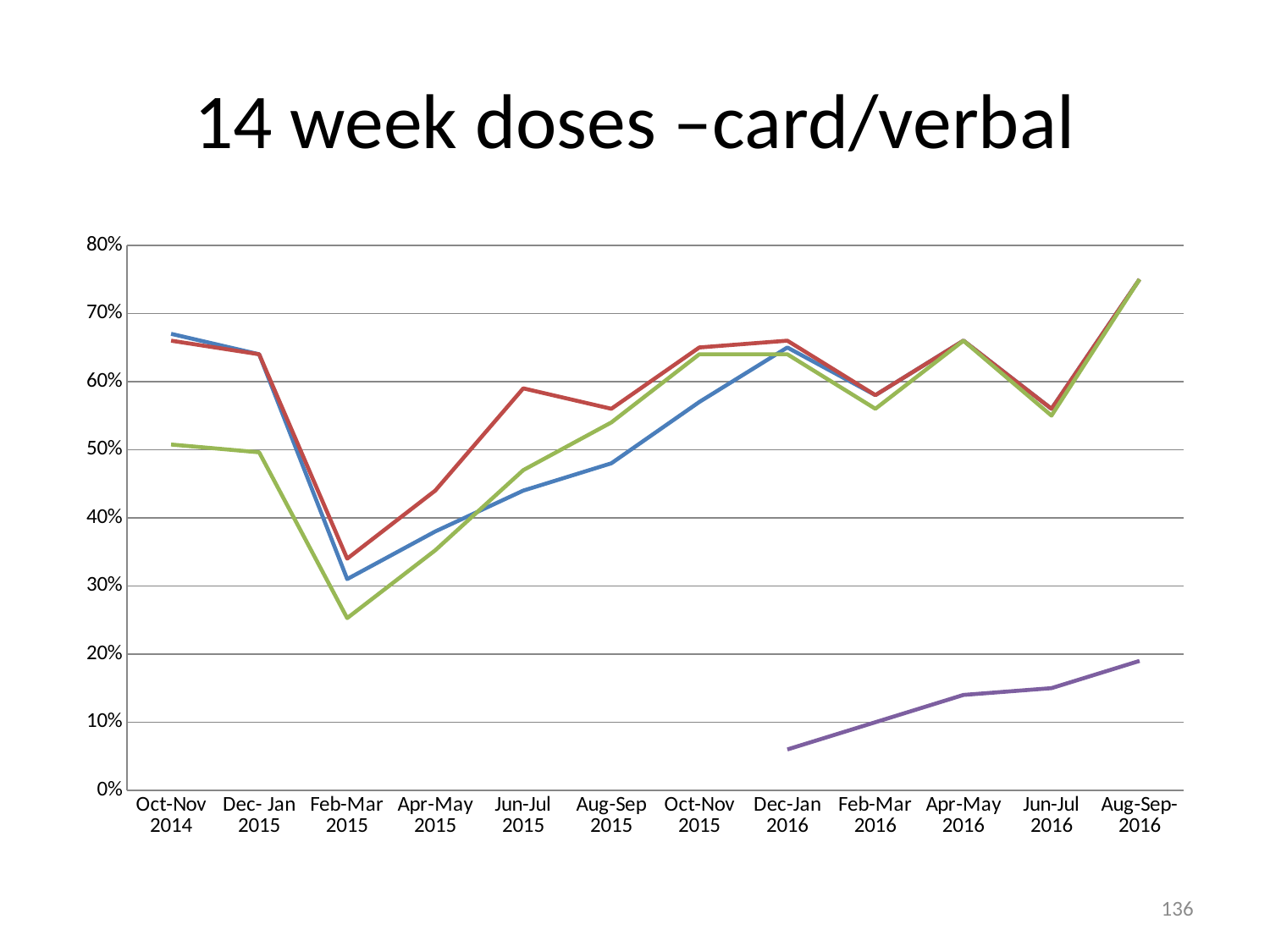
Is the value of the blue line at Oct-Nov 2014 greater or less than 60%? greater Is the value of the purple line at Dec-Jan 2016 greater or less than 10%? less How many time periods are labelled along the x axis? 12 At Feb-Mar 2015, which line has the higher value, the red line or the green line? red line At which period does the green line reach its lowest value? Feb-Mar 2015 How many lines are plotted on the chart? 4 At which period does the green line reach its highest value? Aug-Sep 2016 Does the purple line rise or fall from Dec-Jan 2016 to Aug-Sep 2016? rise What kind of chart is shown on the slide? line chart Is the value of the green line at Aug-Sep 2016 greater or less than 70%? greater What is the title of the chart? 14 week doses –card/verbal